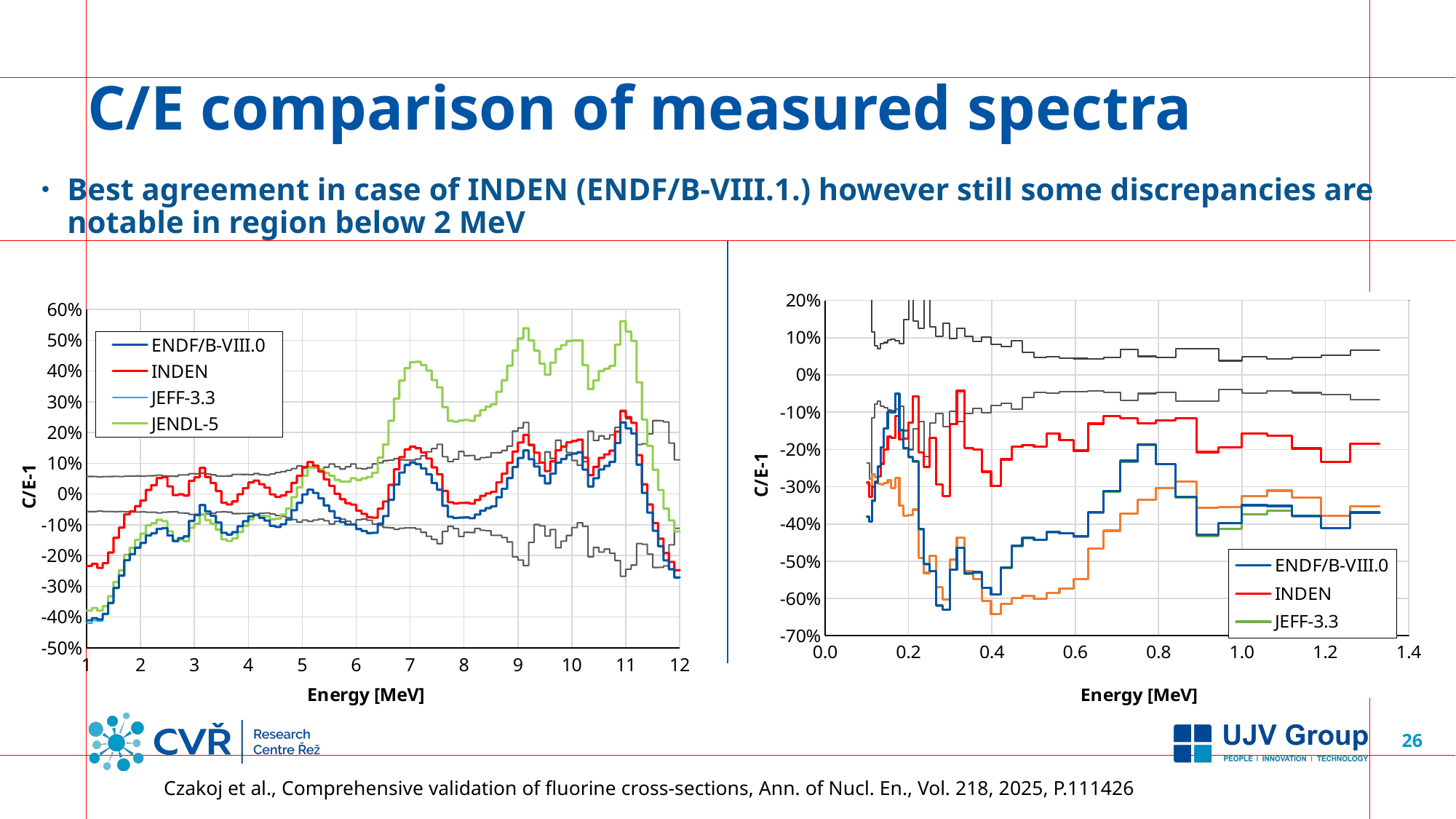
On the right chart, at 0.4 MeV, which is higher: INDEN or ENDF/B-VIII.0? INDEN On the left chart, is the value for JENDL-5 at 7 MeV greater or less than 30%? greater On the left chart, is the value for INDEN at 1 MeV greater or less than -10%? less On the right chart, is the value for INDEN at 0.4 MeV greater or less than -40%? greater On the left chart, what is the label of the y axis? C/E-1 How many series does the legend of the left chart list? 4 On the left chart, which series reaches the highest value? JENDL-5 What kind of chart is the left chart? line chart How many series does the legend of the right chart list? 3 On the left chart, what colour is the INDEN line? red